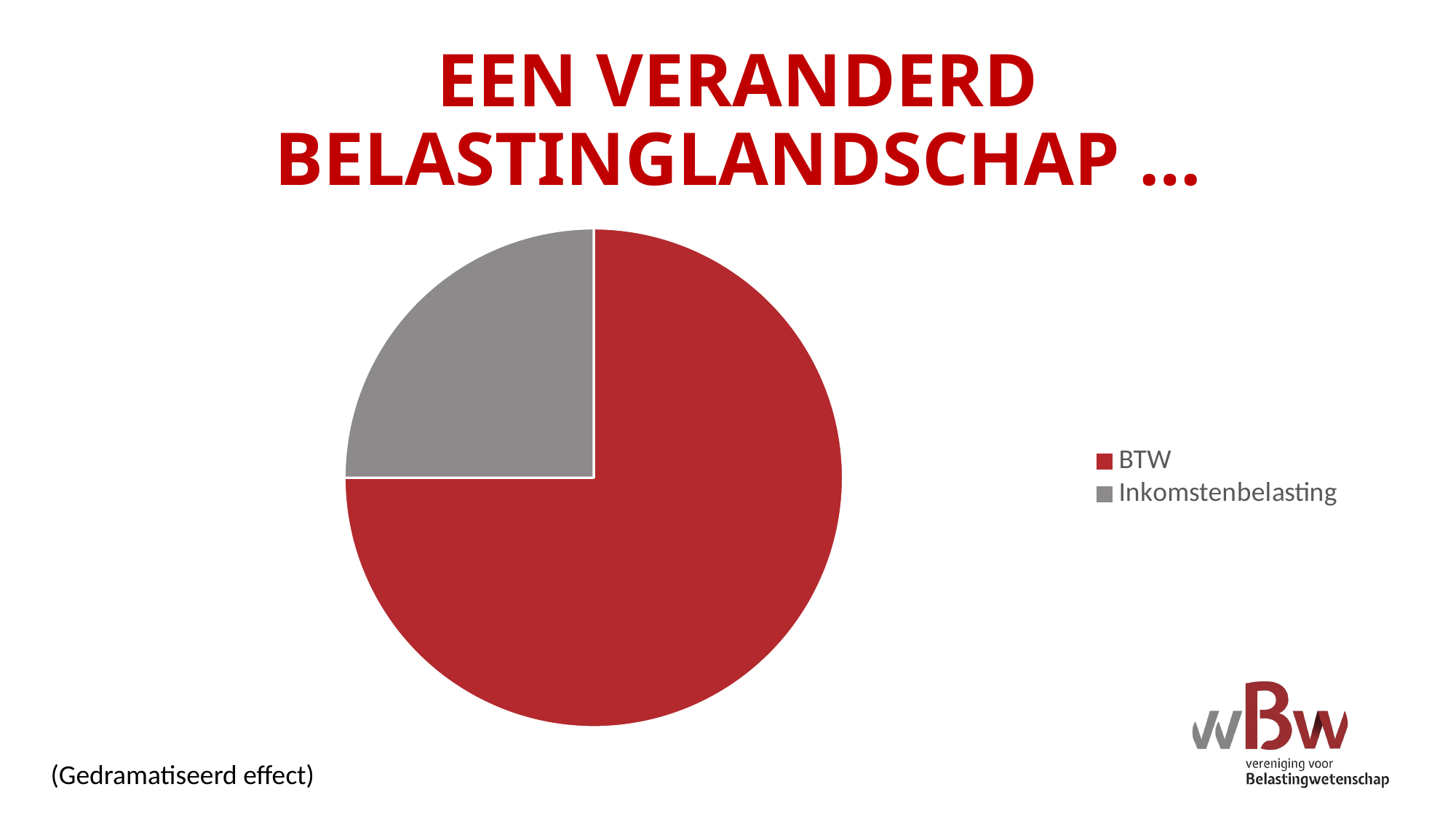
How many entries does the legend of the pie chart list? 2 Which category is shown in grey in the pie chart? Inkomstenbelasting Which slice is larger in the pie chart, BTW or Inkomstenbelasting? BTW What kind of chart is shown on the slide? pie chart Which category has the smallest slice in the pie chart? Inkomstenbelasting Which category has the largest slice in the pie chart? BTW What colour is the BTW slice in the pie chart? red How many slices does the pie chart have? 2